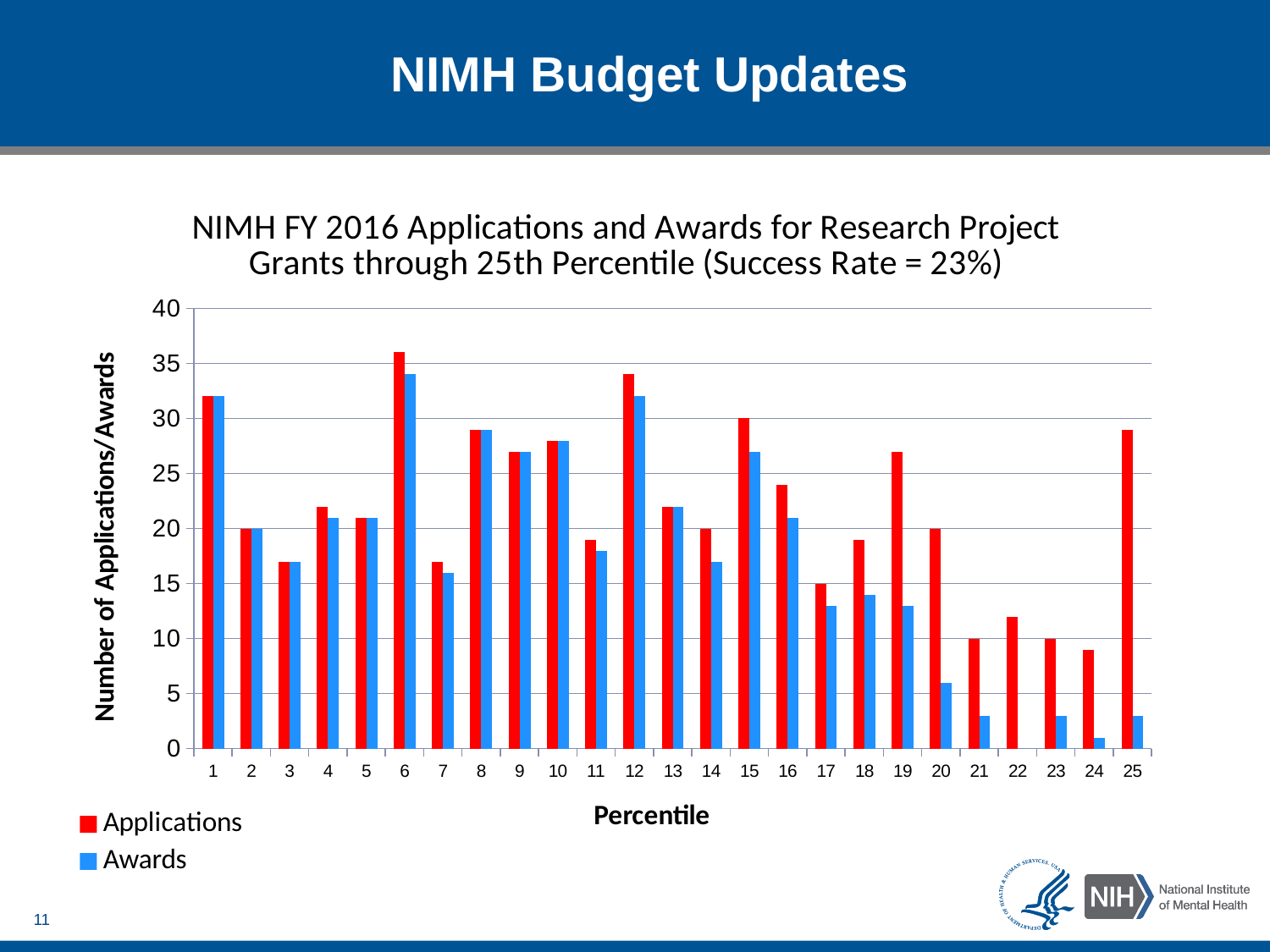
How many series does the legend list? 2 What kind of chart is shown on the slide? bar chart At percentile 19, which is larger: Applications or Awards? Applications What is the number of Applications at percentile 2? 20 At which percentile is the number of Applications highest? 6 What is the number of Applications at percentile 15? 30 What is the success rate stated in the chart title? 23% Is the number of Awards at percentile 20 greater or less than 10? less At which percentile is the number of Awards lowest? 22 How many percentile categories are shown on the x axis? 25 At which percentile is the number of Awards highest? 6 Is the number of Applications at percentile 1 greater or less than 30? greater